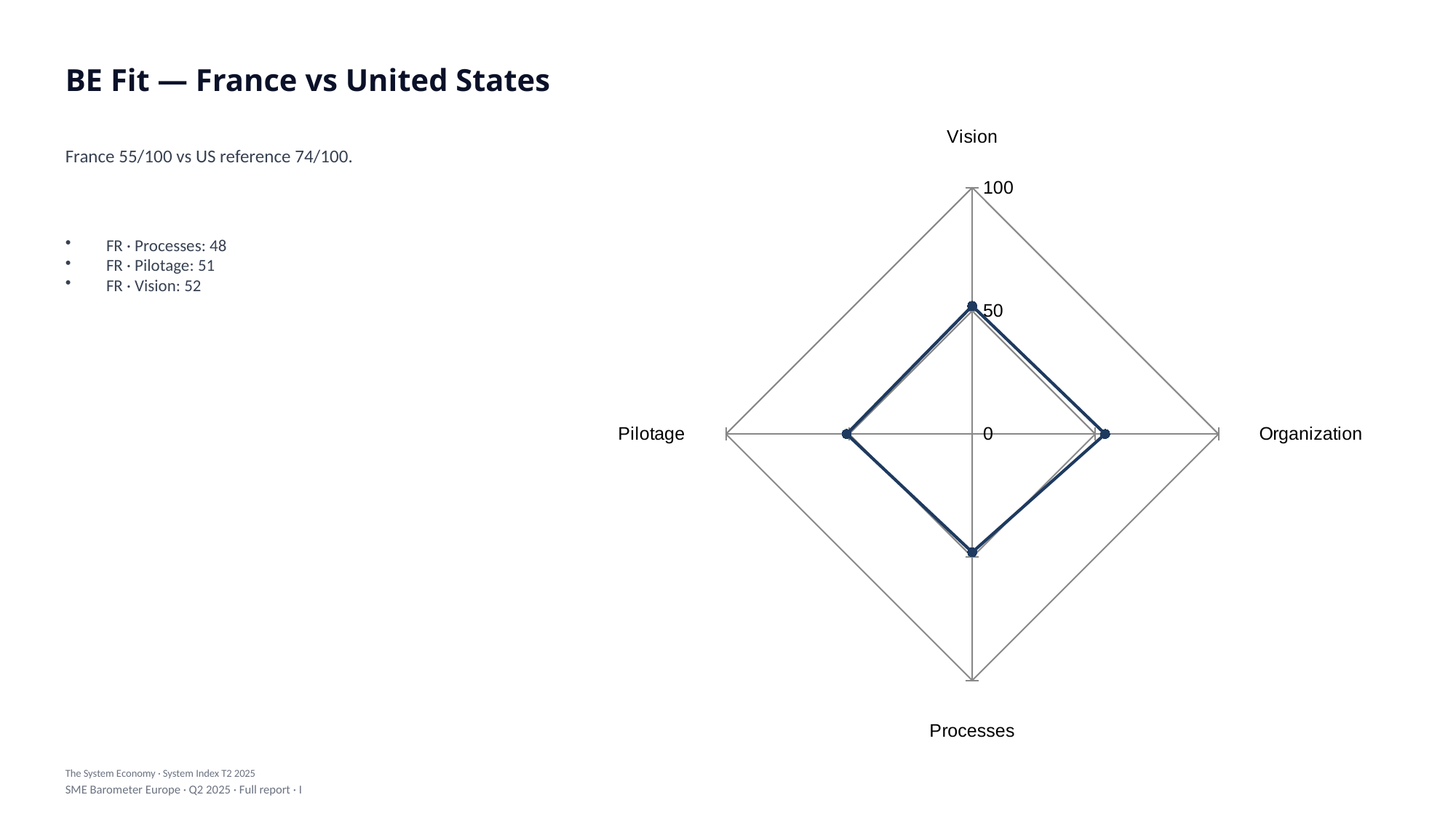
What kind of chart is shown on the slide? radar chart What is the FR value for Vision? 52 What is the highest tick value shown on the radar chart's axis? 100 How many axes (categories) does the radar chart have? 4 Is the value for Pilotage greater or less than 100? less Is the value for Organization greater or less than 100? less Which is larger, the FR value for Vision or the FR value for Processes? Vision What is the difference between the FR values for Vision and Processes? 4 Which category label appears at the top of the radar chart? Vision What is the FR value for Pilotage? 51 What is the FR value for Processes? 48